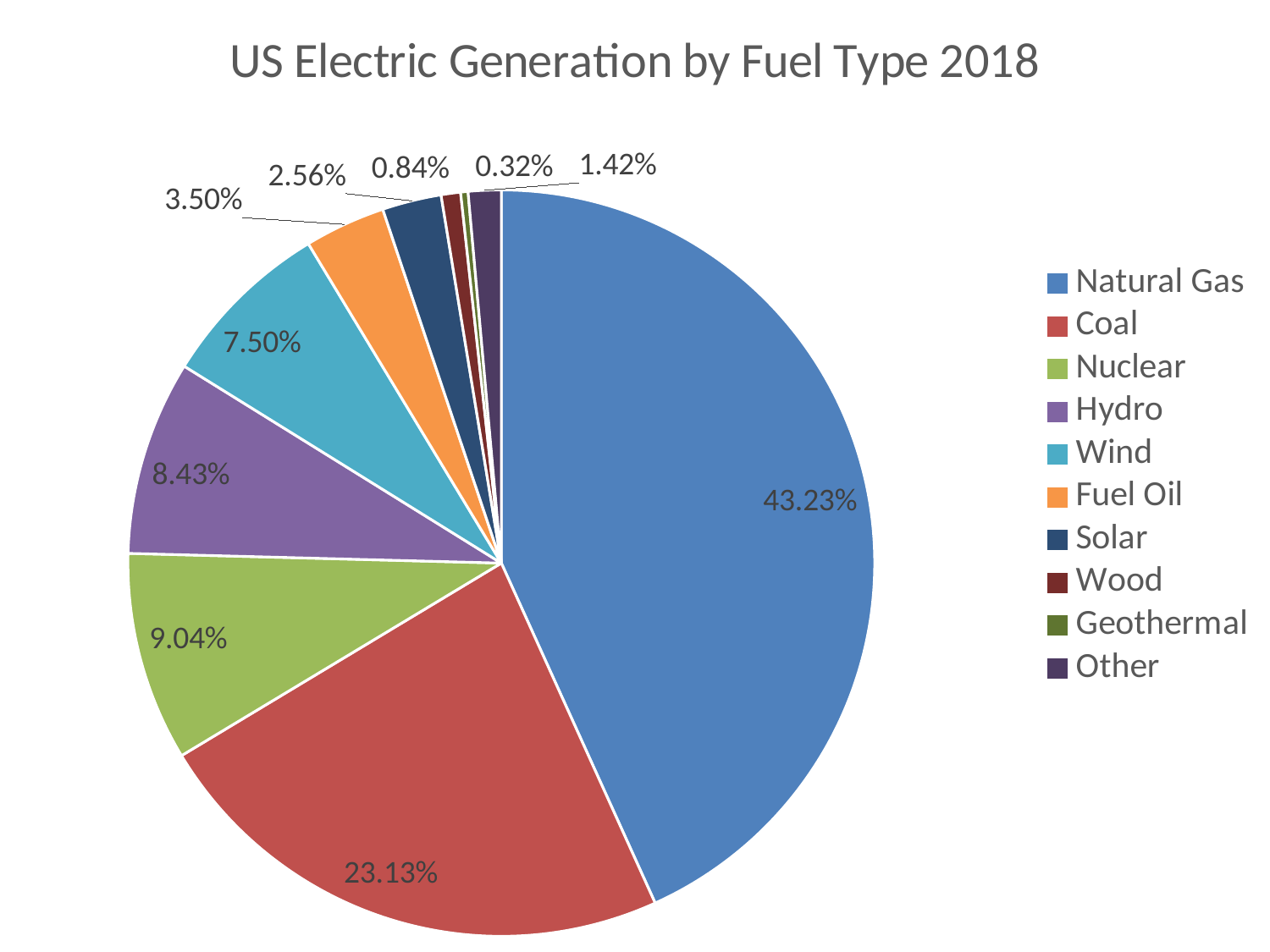
What is the value shown for Wind? 7.50% How many fuel types does the legend list? 10 What is the title of the chart? US Electric Generation by Fuel Type 2018 Which fuel type has the largest slice of the pie? Natural Gas What is the value shown for Coal? 23.13% What kind of chart is shown on the slide? Pie chart What is the value shown for Nuclear? 9.04% What is the value shown for Solar? 2.56% What is the difference between the Natural Gas and Coal shares? 20.10% Which is larger, the share for Hydro or the share for Wind? Hydro Which fuel type has the smallest slice of the pie? Geothermal What share of US electric generation in 2018 does Natural Gas account for? 43.23%